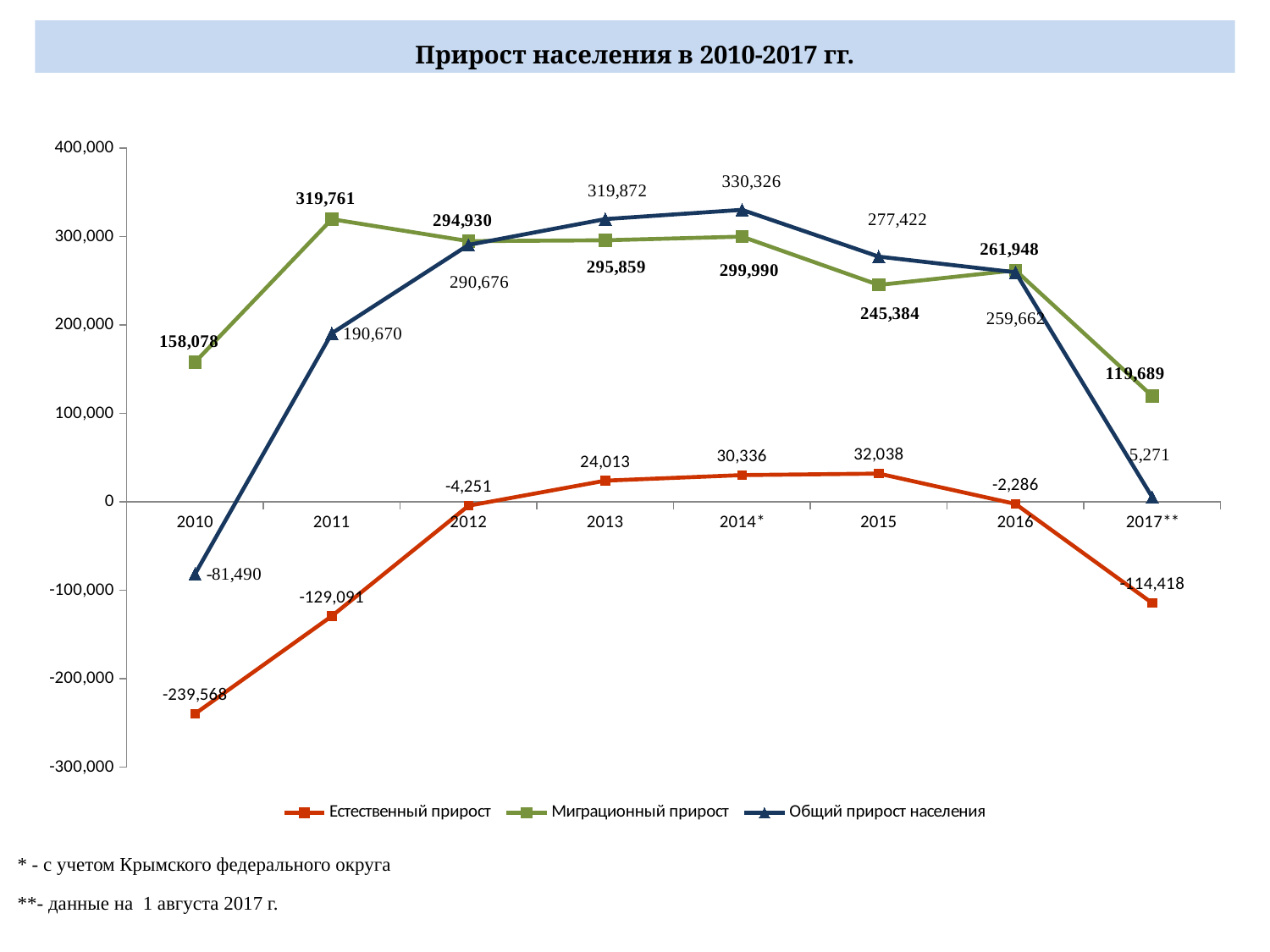
How many series does the legend list? 3 In which year is Естественный прирост lowest? 2010 What is the value of Естественный прирост in 2010? -239,568 Does Естественный прирост rise or fall from 2010 to 2015? rise What is the title of the chart? Прирост населения в 2010-2017 гг. What is the difference between Общий прирост населения in 2014* and in 2015? 52,904 Which is larger in 2016: Миграционный прирост or Общий прирост населения? Миграционный прирост In which year is Общий прирост населения highest? 2014* What type of chart is shown on the slide? line chart What is the value of Общий прирост населения in 2014*? 330,326 What is the value of Миграционный прирост in 2011? 319,761 How many years are plotted along the x axis? 8